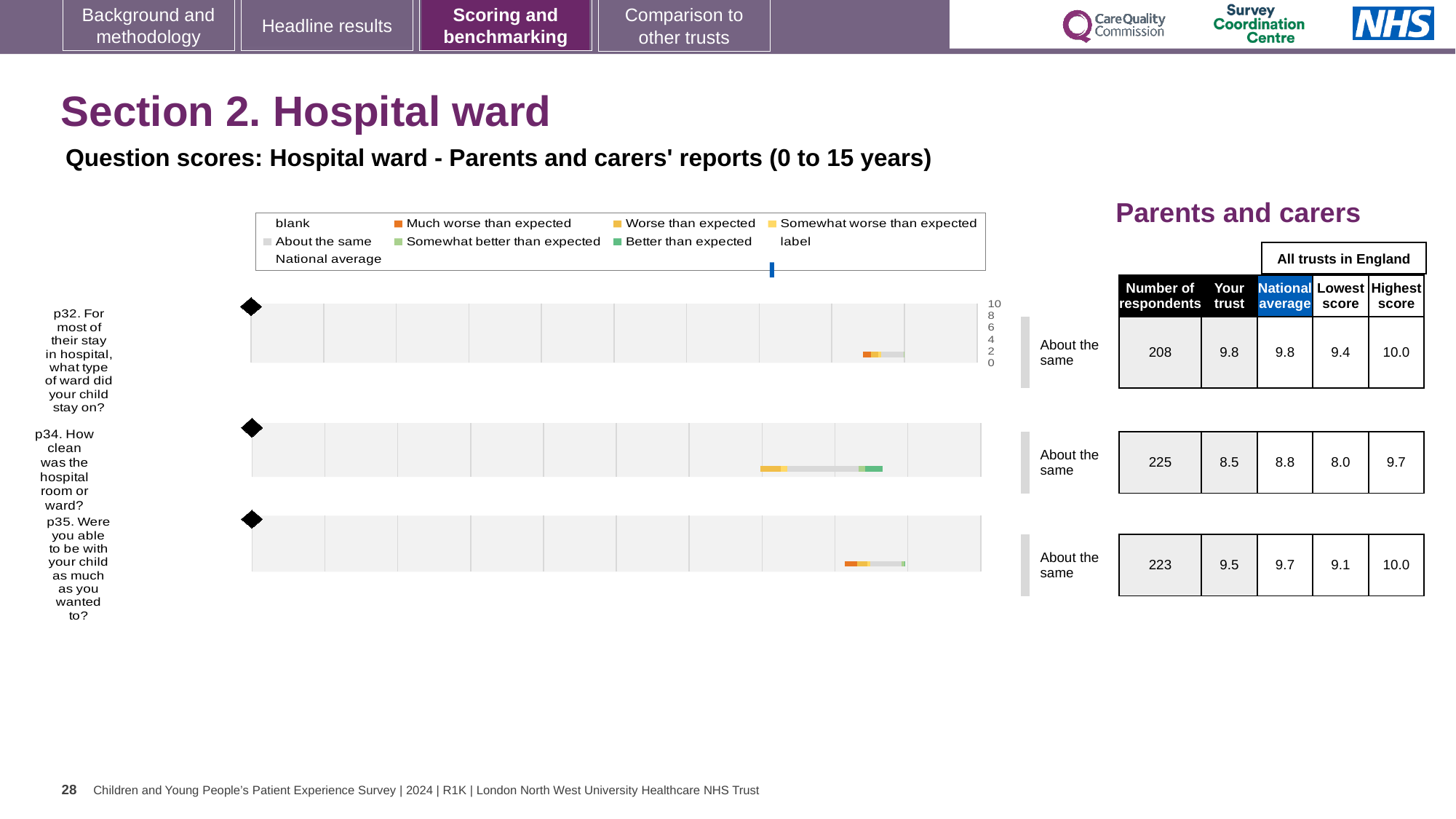
How many respondents answered p32 (what type of ward did your child stay on)? 208 What is the 'Your trust' score for p34 (How clean was the hospital room or ward?)? 8.5 What kind of chart is used to show the question scores on this slide? bar chart Which question has the lowest 'Your trust' score? p34 How many questions (p32, p34, p35) are plotted on the slide? 3 How many entries does the legend above the charts list? 9 What is the difference between the 'Your trust' scores for p32 and p34? 1.3 What is the national average score for p35 (Were you able to be with your child as much as you wanted to)? 9.7 What is the highest score among all trusts in England for p34? 9.7 What benchmark category is shown next to the chart for p34? About the same Which question has the highest 'Your trust' score? p32 For p35, which is larger: the 'Your trust' score or the national average? National average